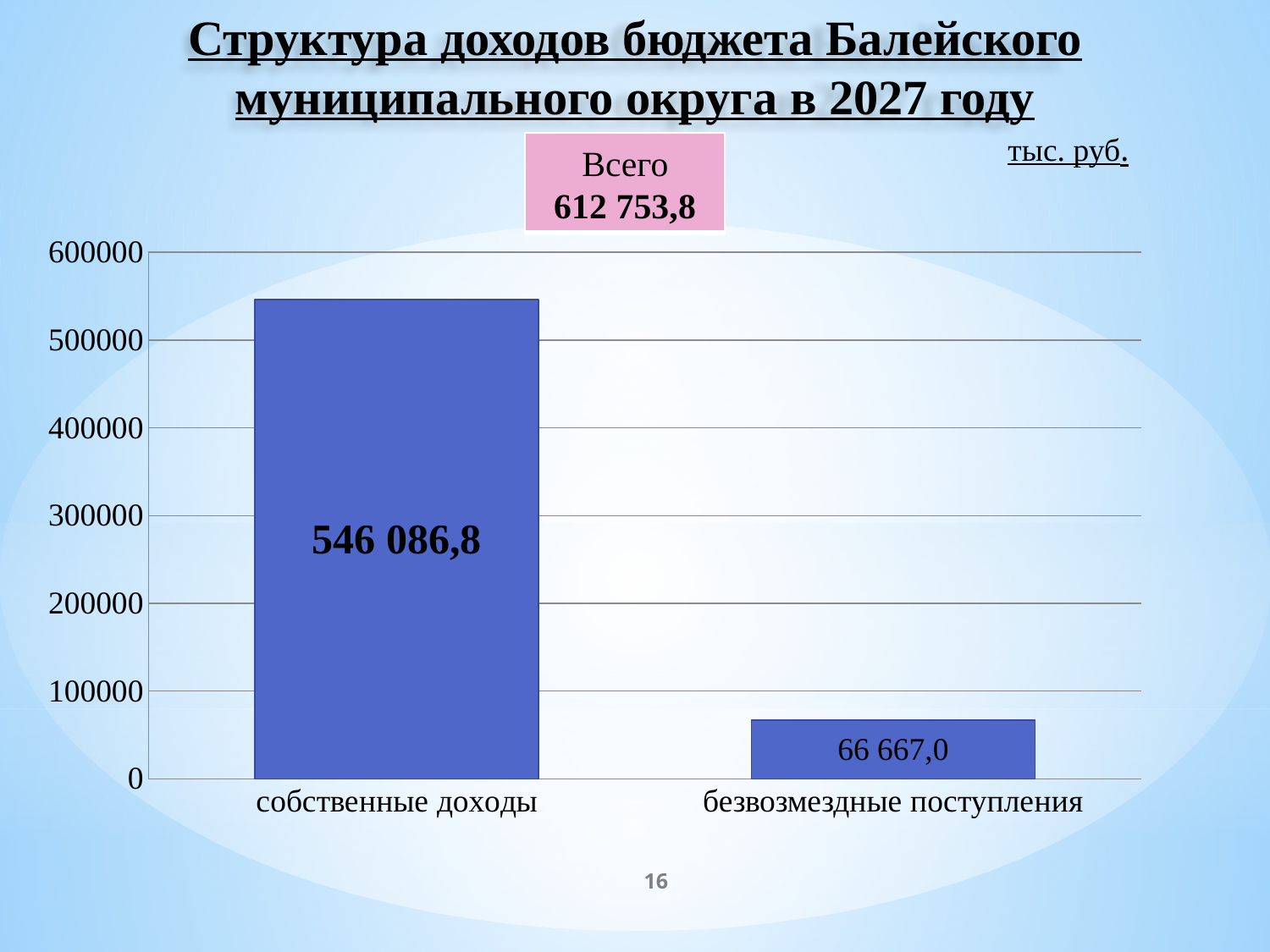
Which category has the highest value? собственные доходы Is the value for собственные доходы greater or less than 500000? greater What is the difference between собственные доходы and безвозмездные поступления? 479 419,8 What is the value for собственные доходы? 546 086,8 Which is larger, собственные доходы or безвозмездные поступления? собственные доходы What total (Всего) is shown on the slide? 612 753,8 Is the value for безвозмездные поступления greater or less than 100000? less What kind of chart is shown on the slide? bar chart How many categories are shown in the chart? 2 Which category has the lowest value? безвозмездные поступления What unit of measurement is indicated on the slide? тыс. руб. What is the value for безвозмездные поступления? 66 667,0